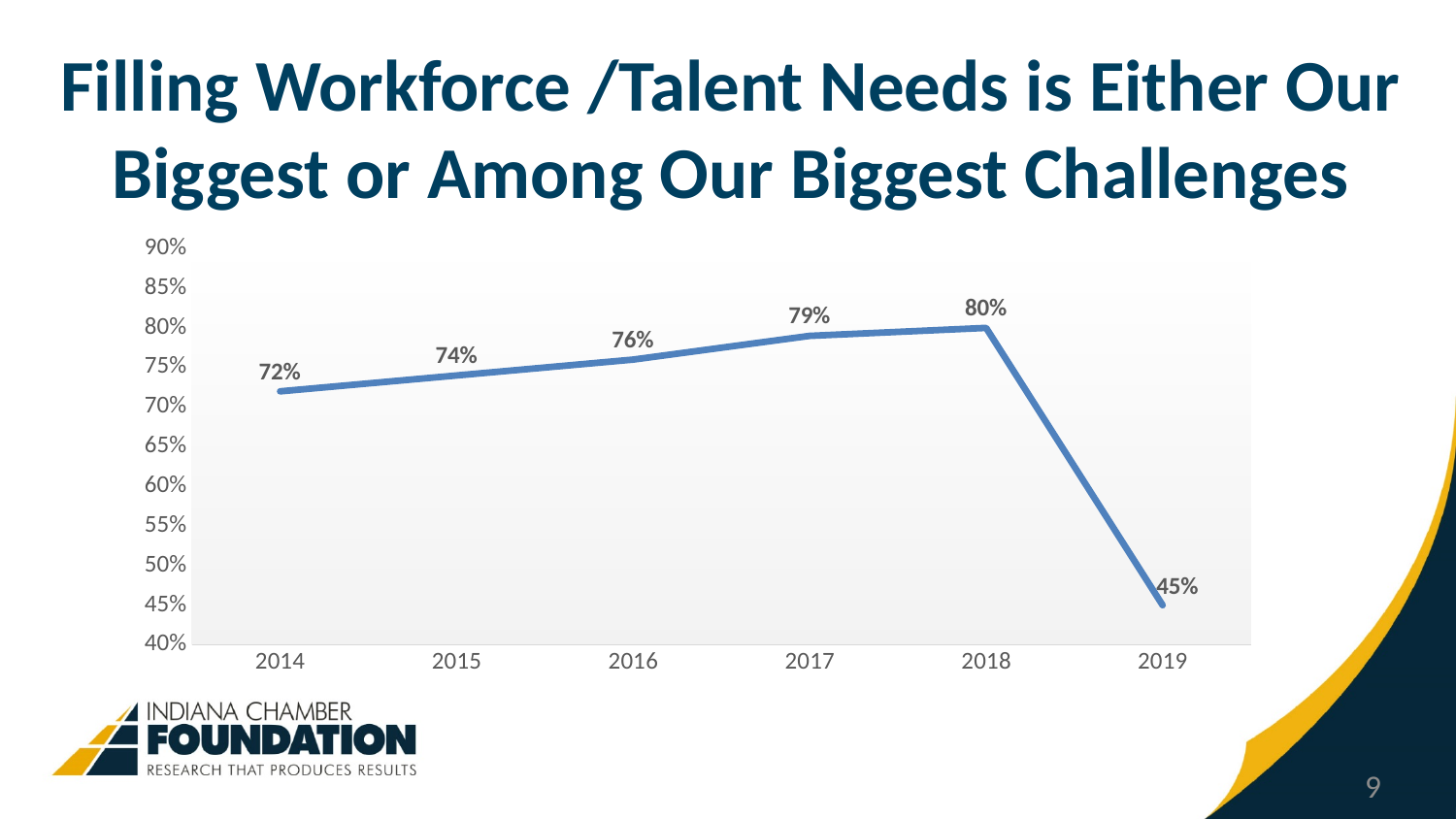
What is the difference between the values for 2018 and 2019? 35% Which year has the lowest value? 2019 What is the value for 2019? 45% What is the value for 2014? 72% Do the values rise or fall from 2014 to 2018? rise What is the value for 2017? 79% What kind of chart is shown on the slide? line chart Which is larger, the value for 2015 or the value for 2017? 2017 Which year has the highest value? 2018 How many years are plotted on the chart? 6 What is the difference between the values for 2014 and 2016? 4% Is the value for 2019 greater or less than 50%? less